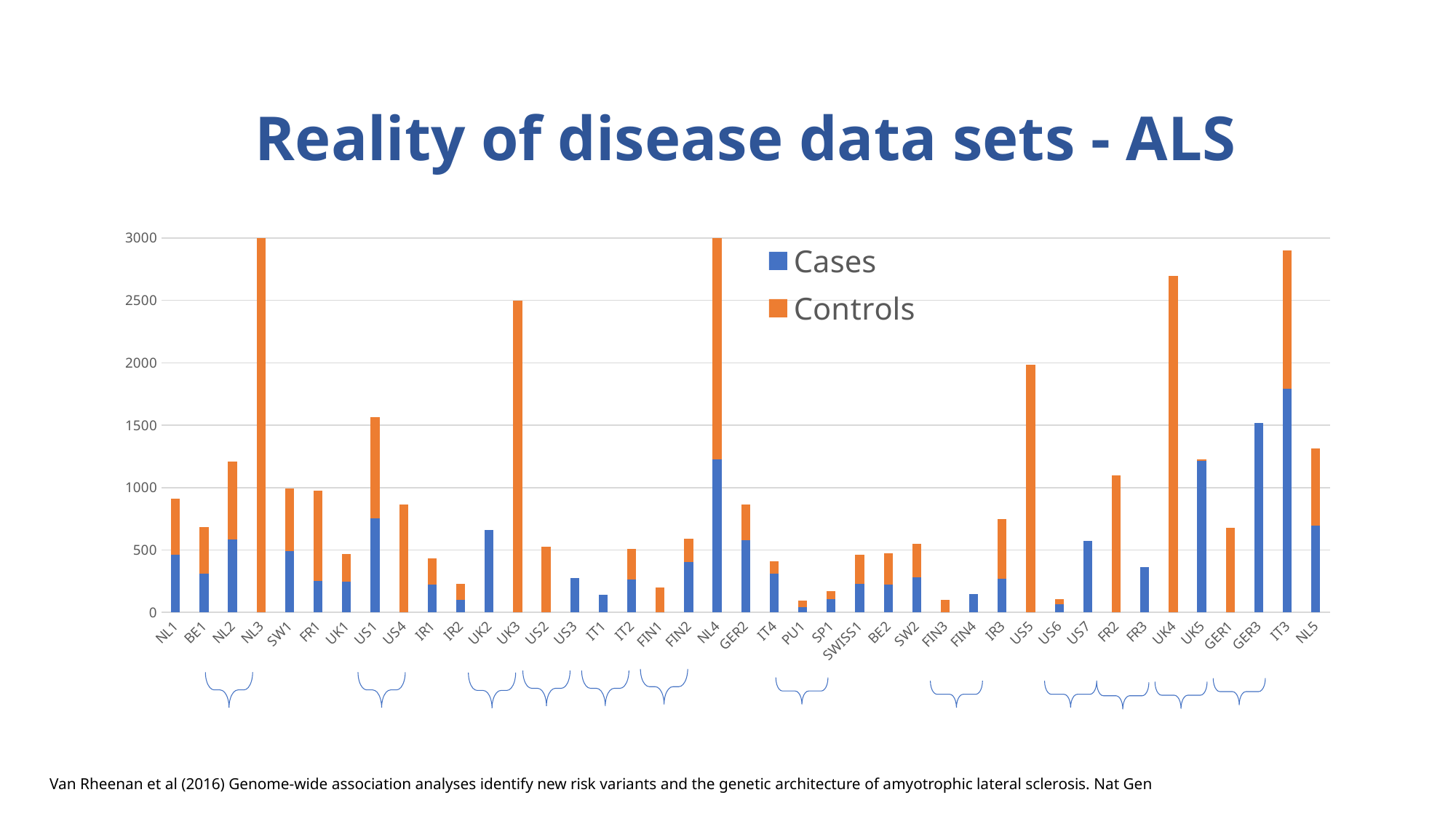
What colour represents Controls in the chart? Orange How many series does the legend list? 2 Is the Cases value for GER3 greater or less than 1000? greater What kind of chart is shown on the slide? Stacked bar chart Which has the larger total bar, NL2 or BE1? NL2 Is the total bar height for UK3 greater or less than 2000? greater Is the total bar height for IT3 greater or less than 2500? greater Which has the larger Cases value, IT3 or GER3? IT3 Which two series are listed in the chart legend? Cases and Controls How many data sets (categories) are shown along the x axis? 41